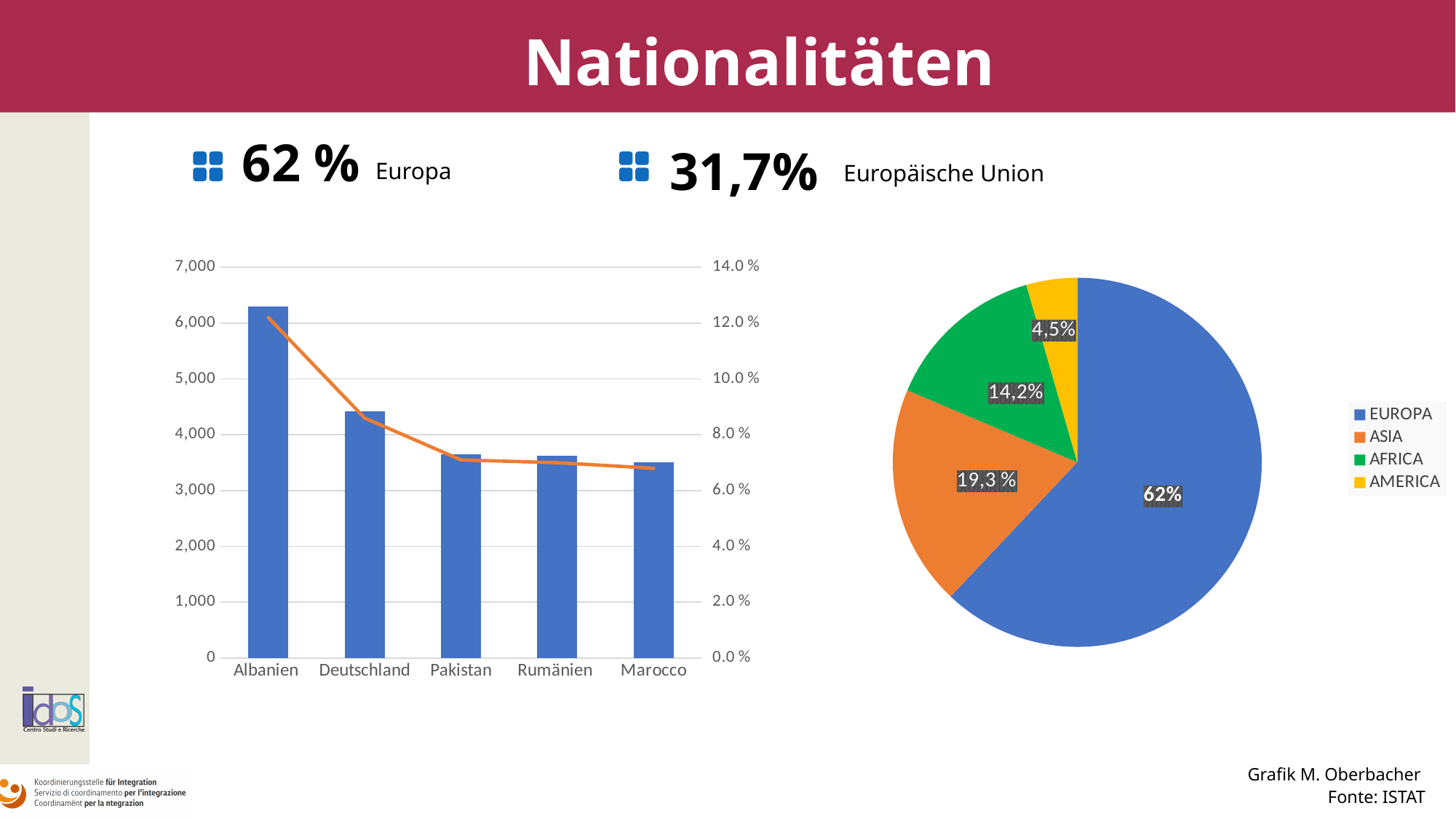
What kind of chart is the chart on the left of the slide? combination bar and line chart In the pie chart on the right, how many percentage points larger is the AFRICA slice than the AMERICA slice? 9,7% In the pie chart on the right, what share does ASIA have? 19,3 % In the pie chart on the right, what share does AFRICA have? 14,2% In the pie chart on the right, how many entries does the legend list? 4 In the pie chart on the right, what share does AMERICA have? 4,5% In the bar chart on the left, do the bar values rise or fall from Albanien to Marocco? fall In the bar chart on the left, which country has the highest bar? Albanien In the bar chart on the left, how many countries are shown on the x axis? 5 In the bar chart on the left, is the value for Deutschland greater or less than 5,000? less In the pie chart on the right, which slice is the largest? EUROPA In the pie chart on the right, which slice is the smallest? AMERICA